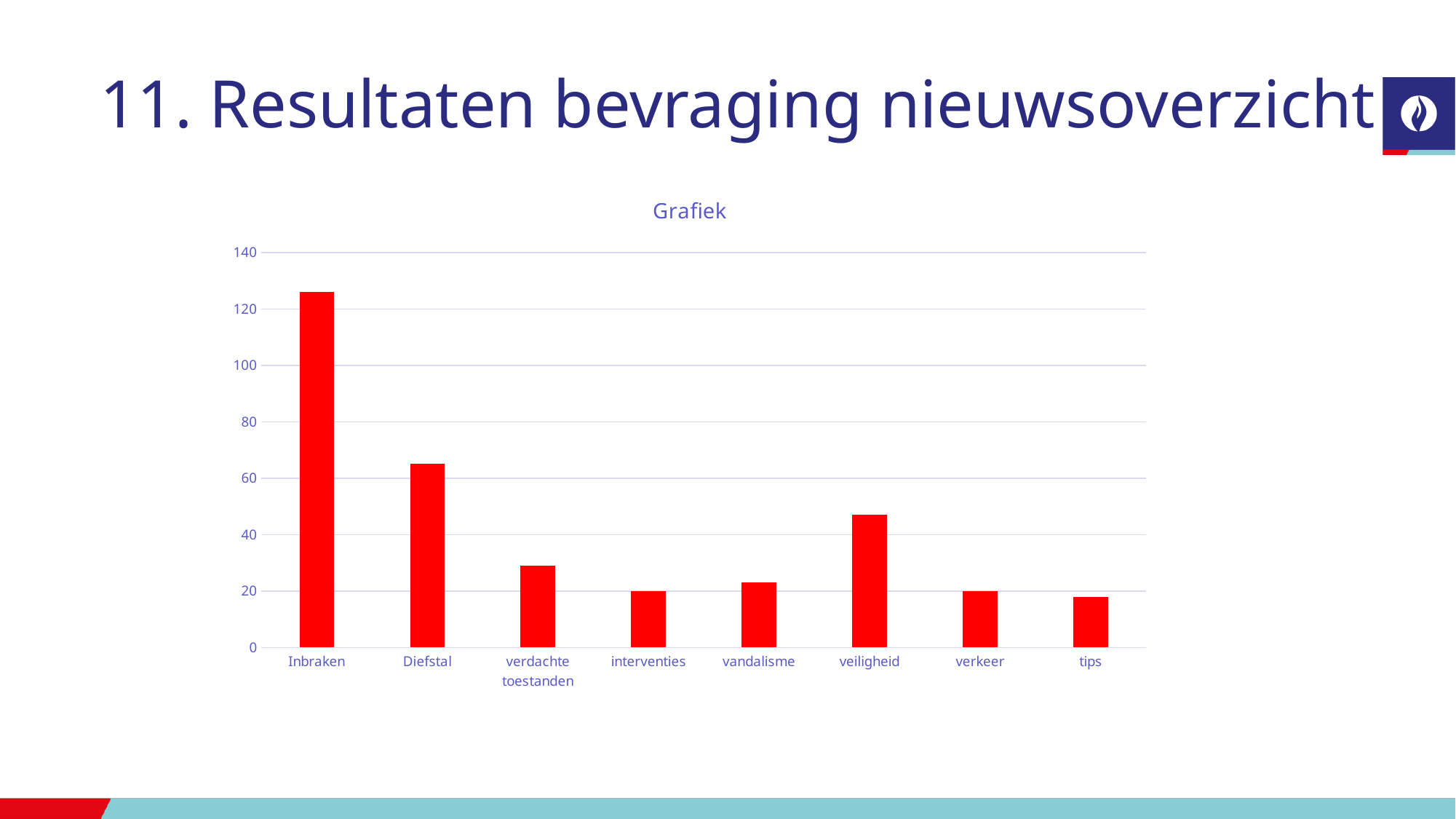
What is the title of the chart? Grafiek Is the value for tips greater or less than 20? less Which is larger, the value for verdachte toestanden or the value for vandalisme? verdachte toestanden How many categories are shown on the x axis of the chart? 8 Which is larger, the value for Diefstal or the value for veiligheid? Diefstal Is the value for veiligheid greater or less than 40? greater Is the value for Diefstal greater or less than 60? greater Which category has the highest value in the chart? Inbraken What colour are the bars in the chart? red What type of chart is shown on the slide? bar chart